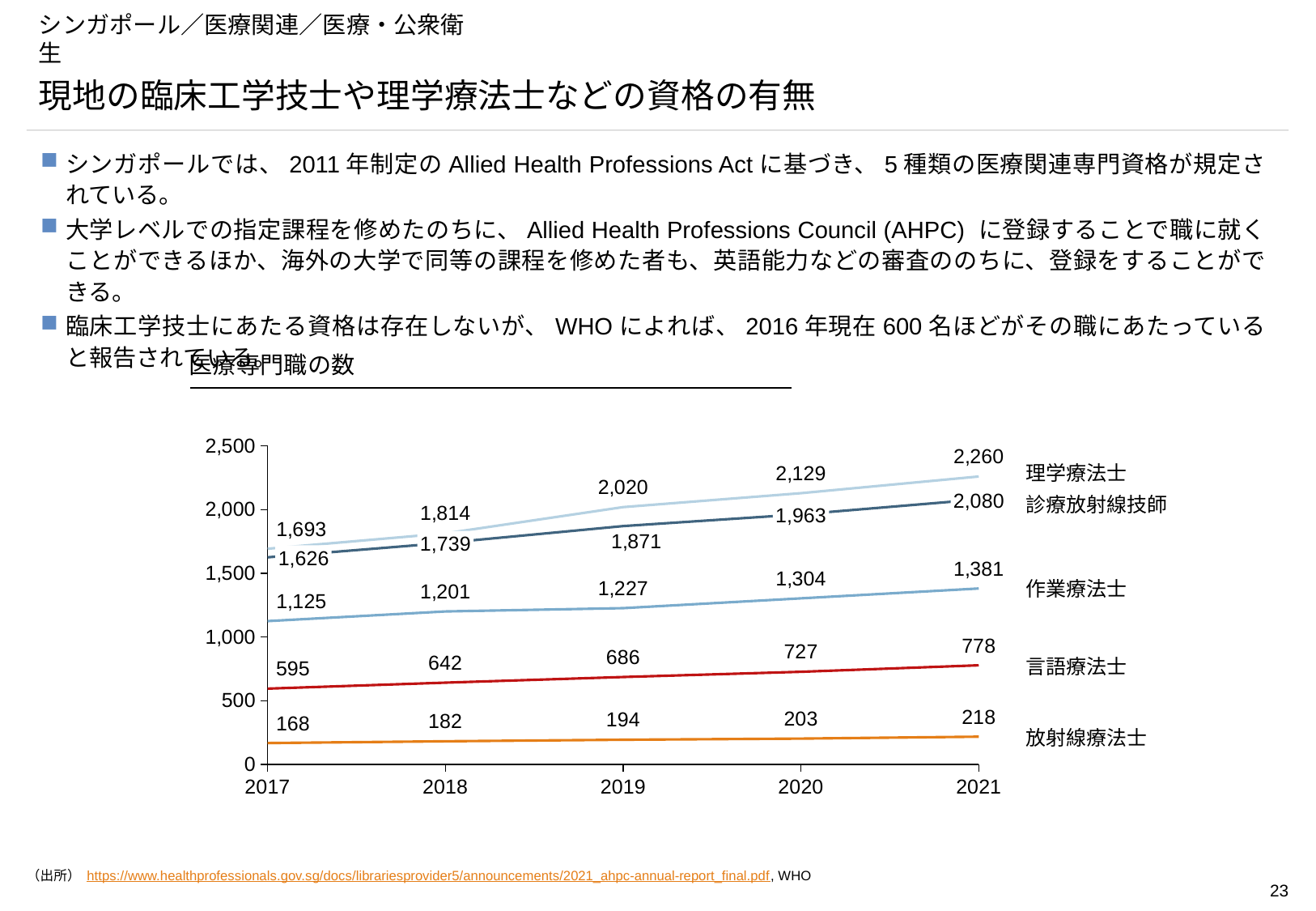
What kind of chart is shown on the slide? line chart What is the value for 放射線療法士 in 2018? 182 What is the value for 診療放射線技師 in 2019? 1,871 What is the value for 作業療法士 in 2017? 1,125 Which profession has the highest value in 2021? 理学療法士 Which is larger in 2019, the value for 作業療法士 or the value for 言語療法士? 作業療法士 What is the value for 理学療法士 in 2021? 2,260 How many years are shown on the x axis? 5 Does the value for 言語療法士 rise or fall from 2017 to 2021? rise What is the difference between the 理学療法士 values in 2021 and 2017? 567 What is the value for 言語療法士 in 2020? 727 Which profession has the lowest value in 2017? 放射線療法士